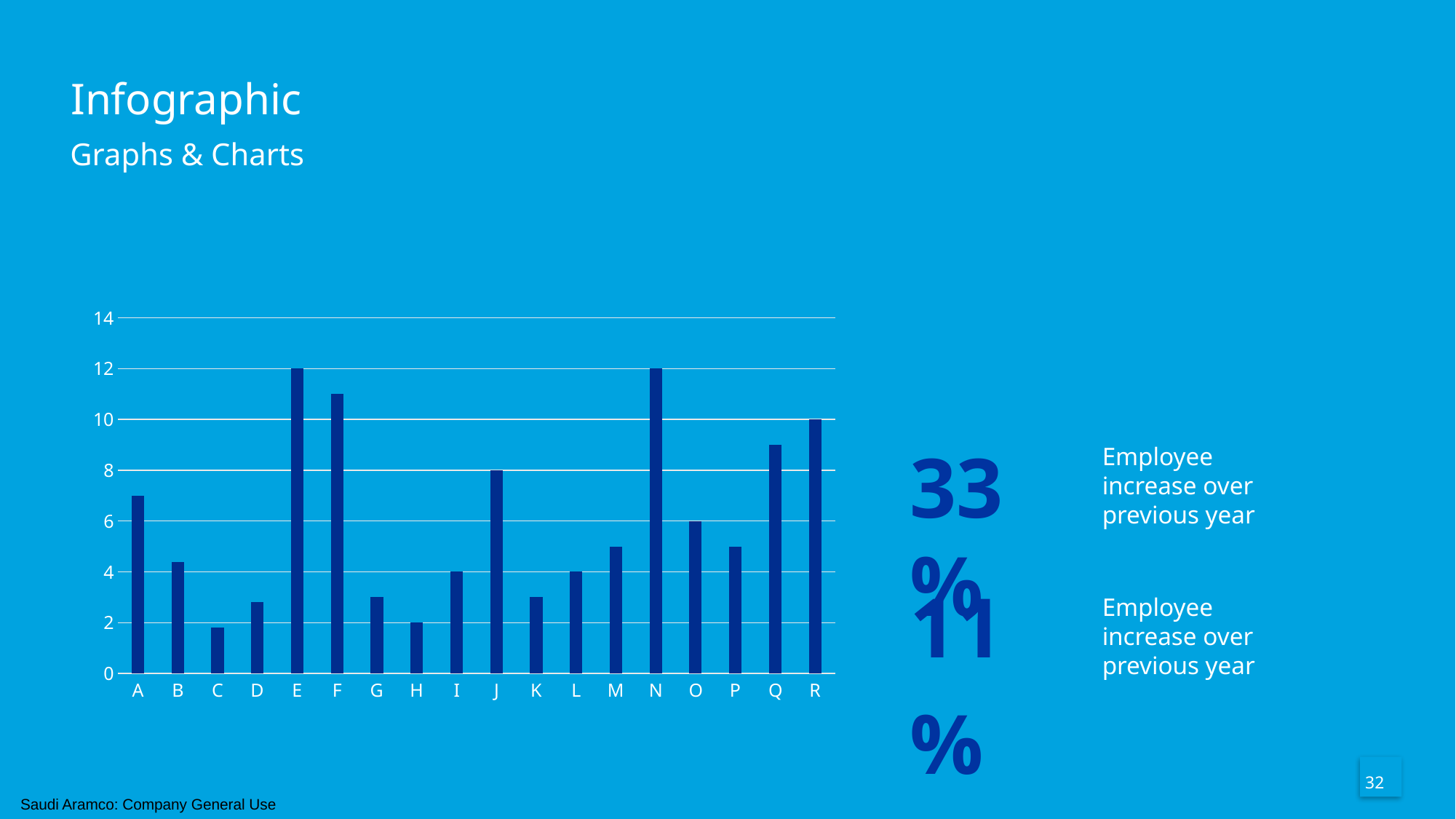
Which is larger, the value for E or the value for A? E How many categories are shown on the x axis of the bar chart? 18 What is the value for category O? 6 What is the value for category N? 12 Is the value for A greater or less than 6? greater What is the value for category R? 10 Is the value for F greater or less than 10? greater Which is larger, the value for G or the value for F? F What is the value for category E? 12 What is the value for category J? 8 Is the value for Q greater or less than 8? greater What kind of chart is shown on the slide? bar chart